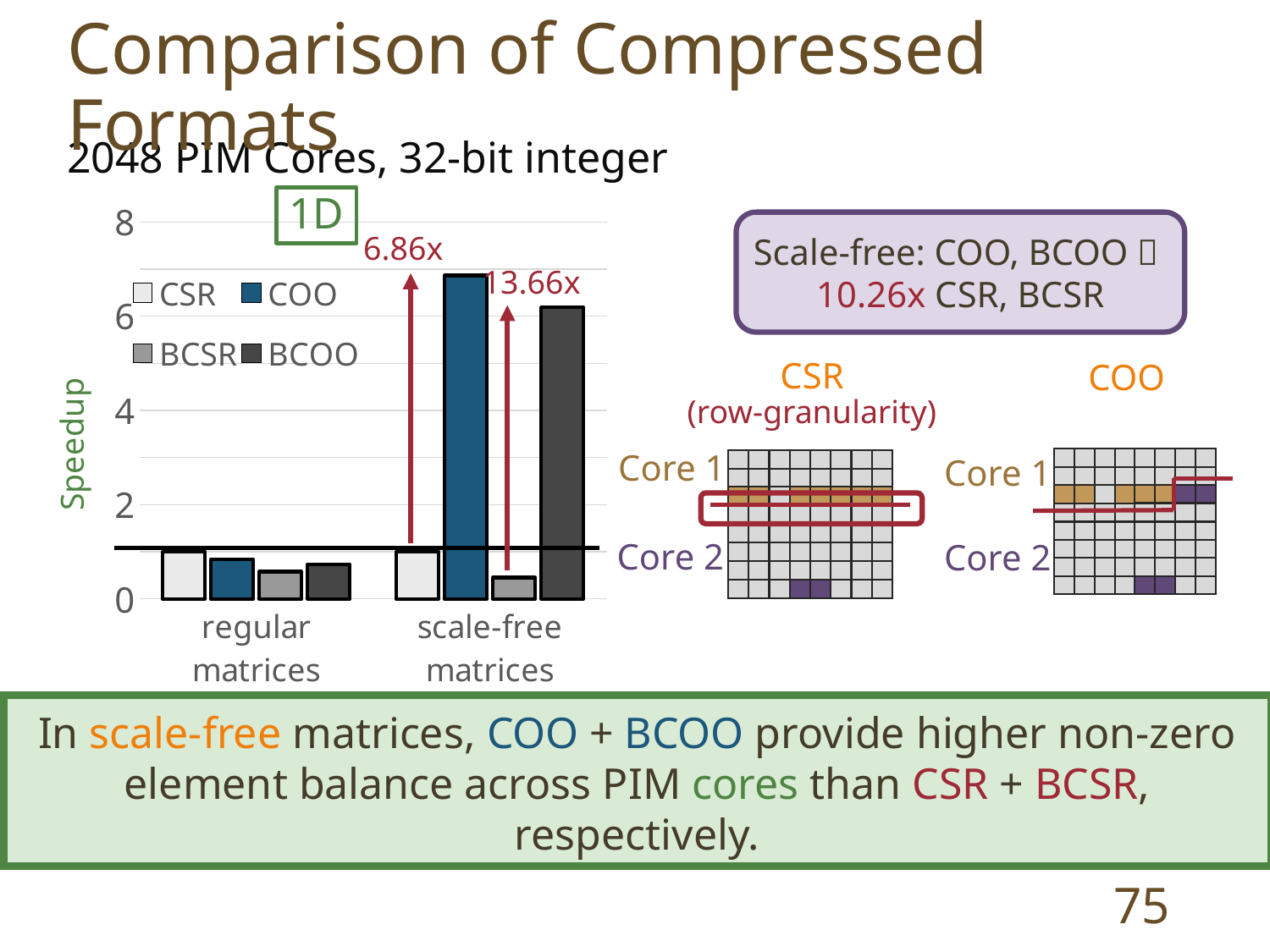
What are the four series listed in the chart legend? CSR, COO, BCSR, BCOO For regular matrices, which has the larger speedup, CSR or COO? CSR How many series does the chart legend list? 4 Is the speedup of COO for scale-free matrices greater or less than 6? greater What is the label of the y axis of the chart? Speedup What kind of chart is shown on the slide? bar chart Is the speedup of BCSR for scale-free matrices greater or less than 2? less Which series has the highest speedup for scale-free matrices? COO Which series has the lowest speedup for scale-free matrices? BCSR For scale-free matrices, which has the larger speedup, COO or BCOO? COO Is the speedup of BCOO for scale-free matrices greater or less than 4? greater How many categories are shown on the x axis of the chart? 2